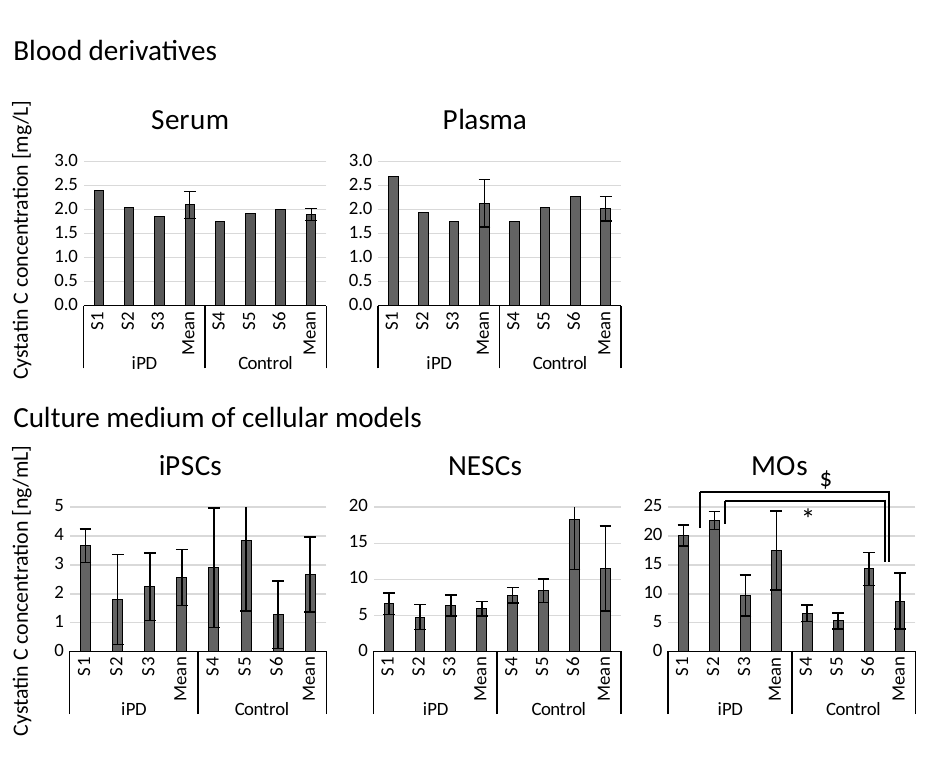
In the iPSCs chart, which bar is the lowest? S6 In the iPSCs chart, is the value for S1 greater or less than 3? greater In the NESCs chart, is the value for S6 greater or less than 15? greater In the Plasma chart, is the value for S1 greater or less than 2.5? greater In the MOs chart, which bar is the highest? S2 How many bars are plotted in the MOs chart? 8 In the Serum chart, which bar is the highest? S1 In the Plasma chart, which of S1 and S2 has the larger value? S1 In the NESCs chart, which bar is the highest? S6 What kind of chart is the Serum chart? bar chart